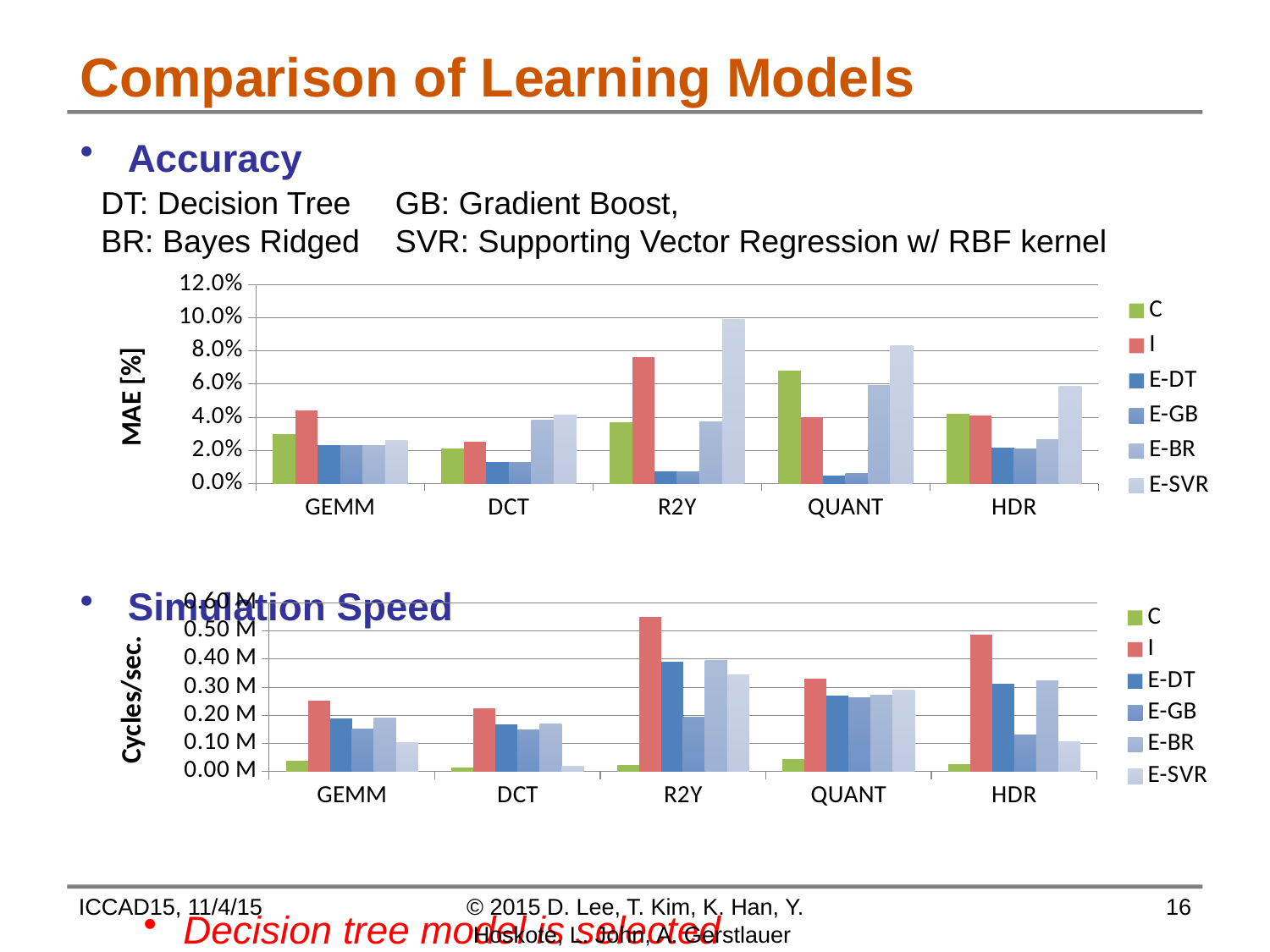
In the Accuracy chart (MAE [%]), which series has the highest MAE for R2Y? E-SVR In the Simulation Speed chart (Cycles/sec.), is the I value for R2Y greater or less than 0.50 M? greater In the Accuracy chart (MAE [%]), which is larger for R2Y: the I value or the C value? I What is the y-axis label of the Accuracy chart? MAE [%] In the Simulation Speed chart (Cycles/sec.), which series has the highest value for HDR? I In the Simulation Speed chart (Cycles/sec.), which series has the lowest value for DCT? C In the Simulation Speed chart (Cycles/sec.), which is larger for GEMM: the E-DT value or the E-SVR value? E-DT What kind of chart is the Simulation Speed chart (Cycles/sec.)? bar chart In the Accuracy chart (MAE [%]), how many benchmark categories are shown on the x axis? 5 In the Accuracy chart (MAE [%]), is the E-SVR value for R2Y greater or less than 8.0%? greater In the Accuracy chart (MAE [%]), how many series does the legend list? 6 In the Accuracy chart (MAE [%]), is the C value for QUANT greater or less than 6.0%? greater